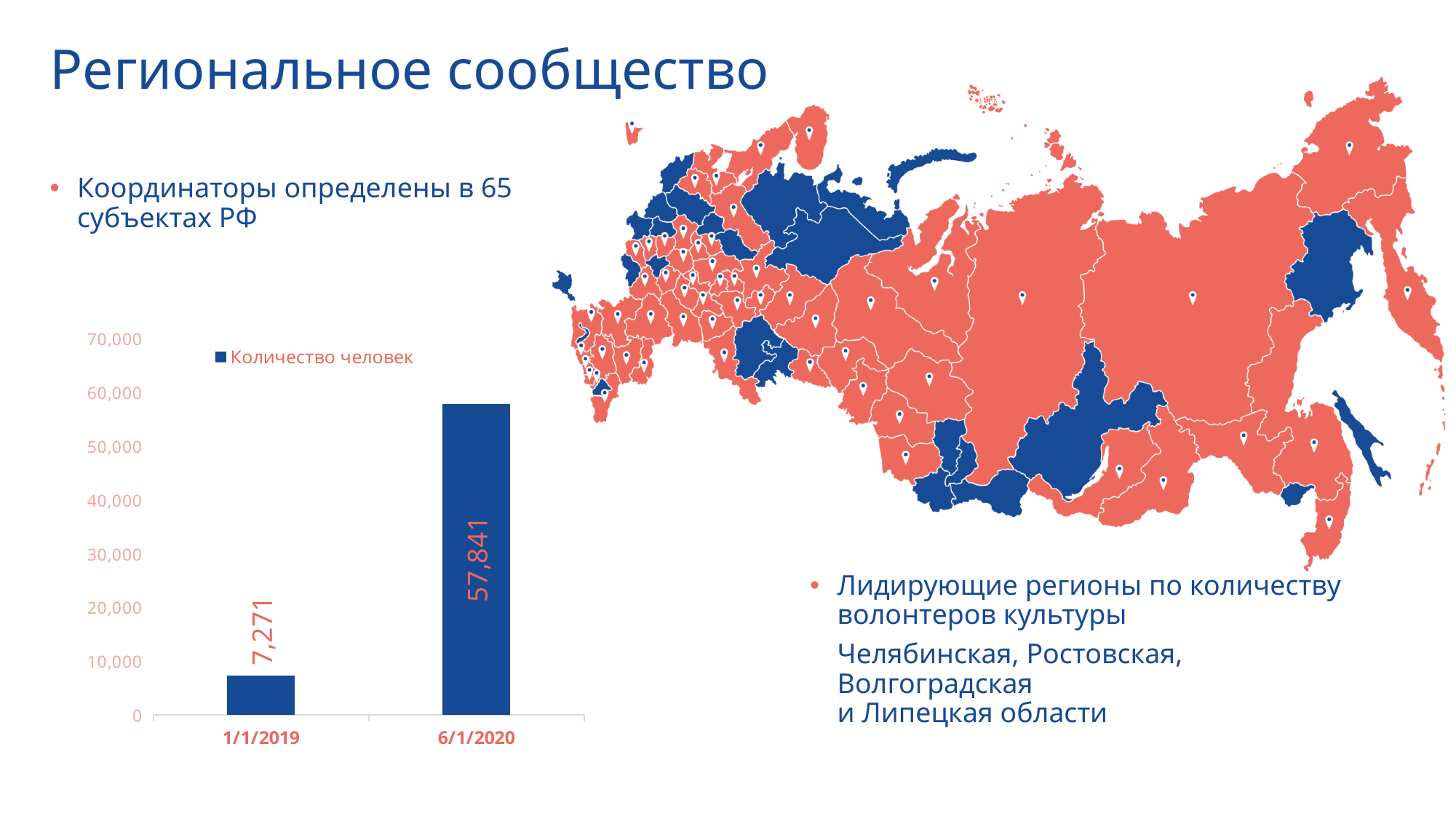
How many series does the legend of the bar chart list? 1 Is the value for 1/1/2019 in the bar chart greater or less than 10,000? less Is the value for 6/1/2020 in the bar chart greater or less than 50,000? greater What is the legend entry of the bar chart? Количество человек Which date has the highest value in the bar chart? 6/1/2020 What is the difference between the values for 6/1/2020 and 1/1/2019 in the bar chart? 50,570 Which date has the lowest value in the bar chart? 1/1/2019 What type of chart is shown on the slide? bar chart How many bars are shown in the bar chart? 2 What is the value for 6/1/2020 in the bar chart? 57,841 Which is larger in the bar chart: the value for 1/1/2019 or the value for 6/1/2020? 6/1/2020 What is the value for 1/1/2019 in the bar chart? 7,271